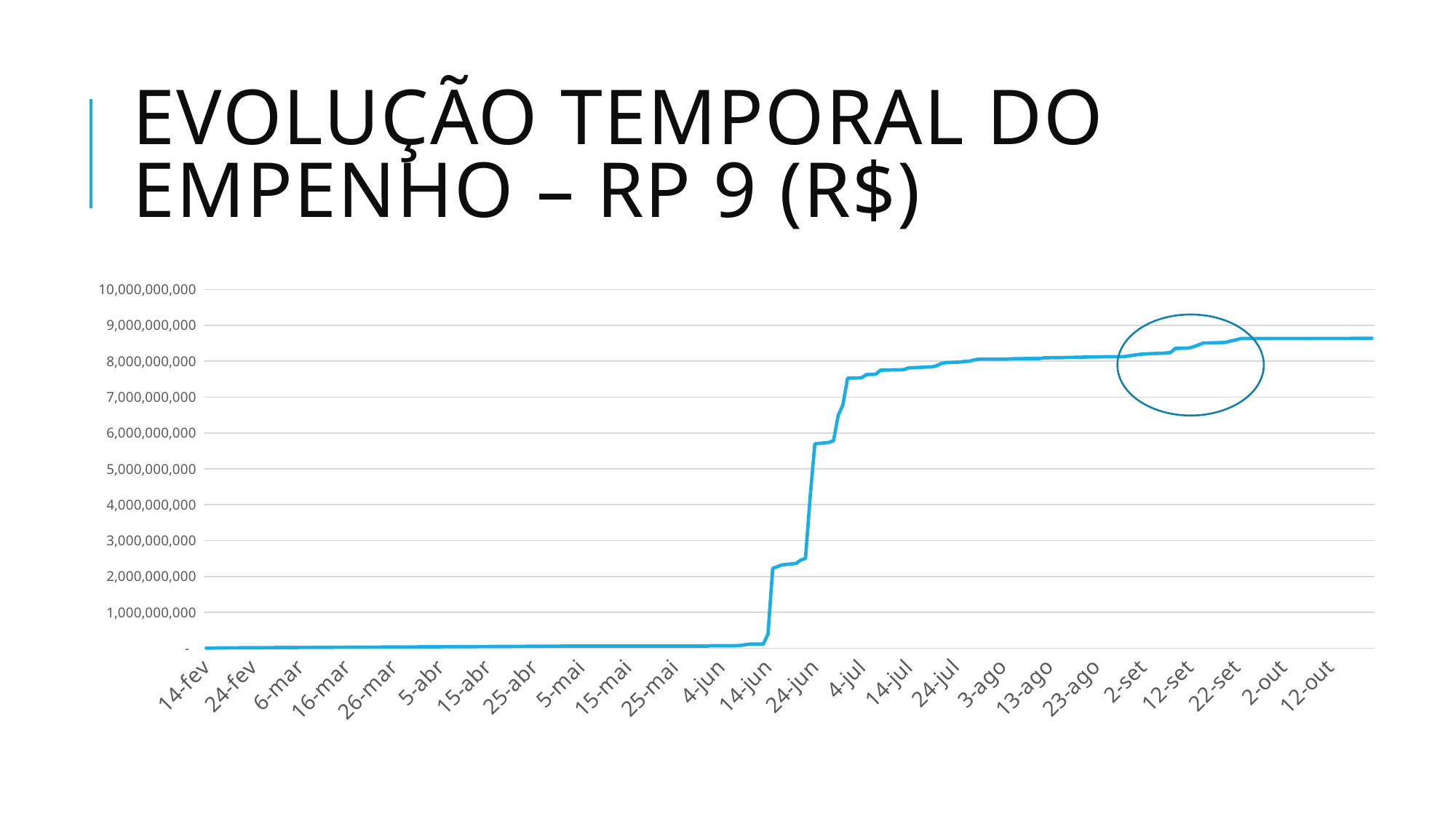
Is the value for 4-jul greater or less than 7,000,000,000? greater What is the highest value shown on the y axis? 10,000,000,000 What is the title of the chart on the slide? EVOLUÇÃO TEMPORAL DO EMPENHO – RP 9 (R$) How many date labels are shown on the x axis? 25 Is the value for 12-out greater or less than 9,000,000,000? less What kind of chart is shown on the slide? line chart Is the value for 14-jul greater or less than 8,000,000,000? less Which is larger, the value for 14-fev or the value for 12-out? 12-out Do the values generally rise or fall along the x axis from 14-fev to 12-out? rise